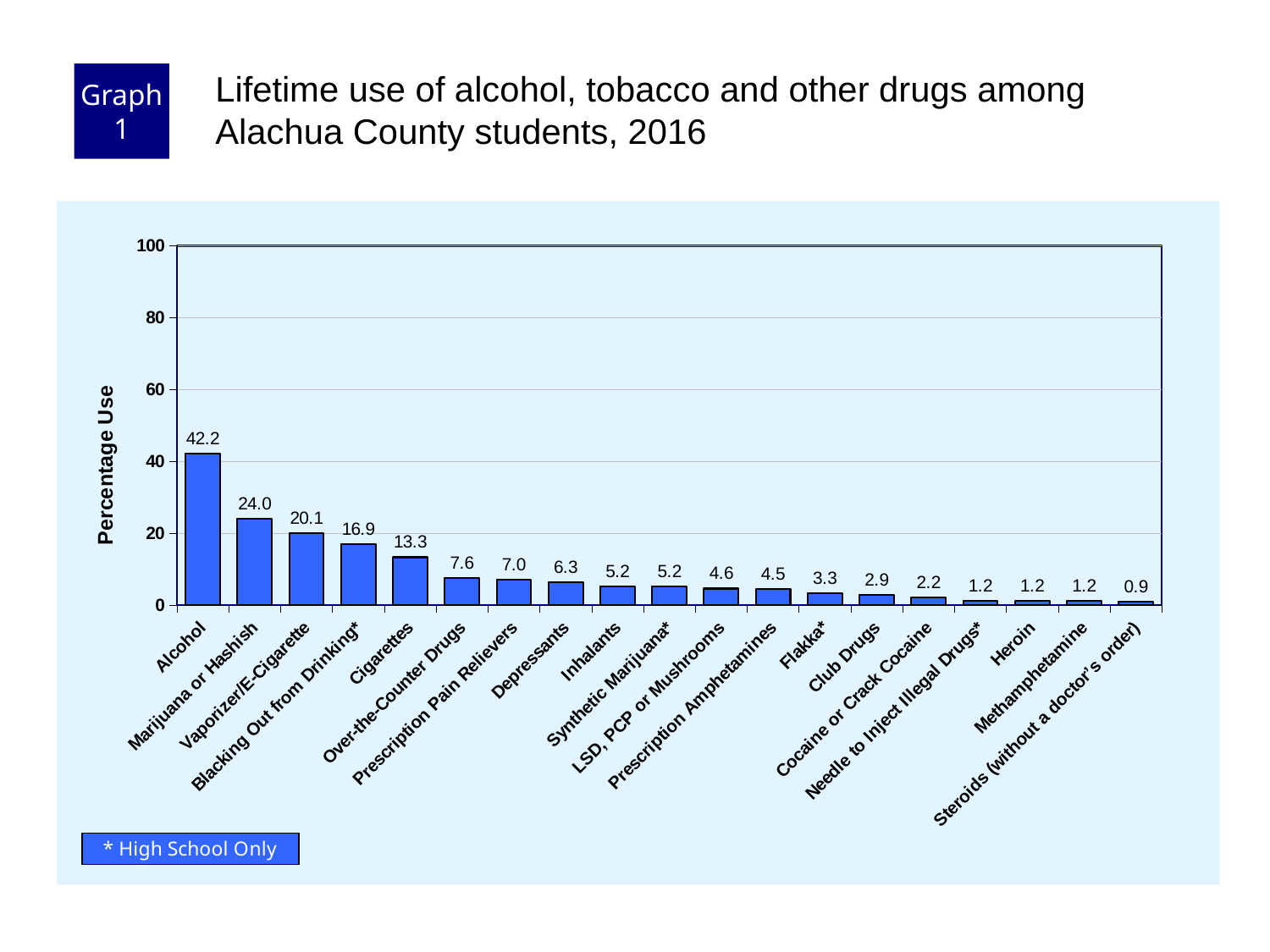
Is the value for Marijuana or Hashish greater or less than 20? greater Which category has the highest percentage use? Alcohol What is the percentage use for Alcohol? 42.2 What is the difference in percentage use between Alcohol and Marijuana or Hashish? 18.2 Which category has the lowest percentage use? Steroids (without a doctor's order) Which has a higher percentage use, Over-the-Counter Drugs or Depressants? Over-the-Counter Drugs What is the label of the y axis? Percentage Use What kind of chart is shown on the slide? Bar chart What is the percentage use for Cigarettes? 13.3 What is the percentage use for Vaporizer/E-Cigarette? 20.1 How many categories are shown on the x axis? 19 What is the percentage use for Flakka*? 3.3